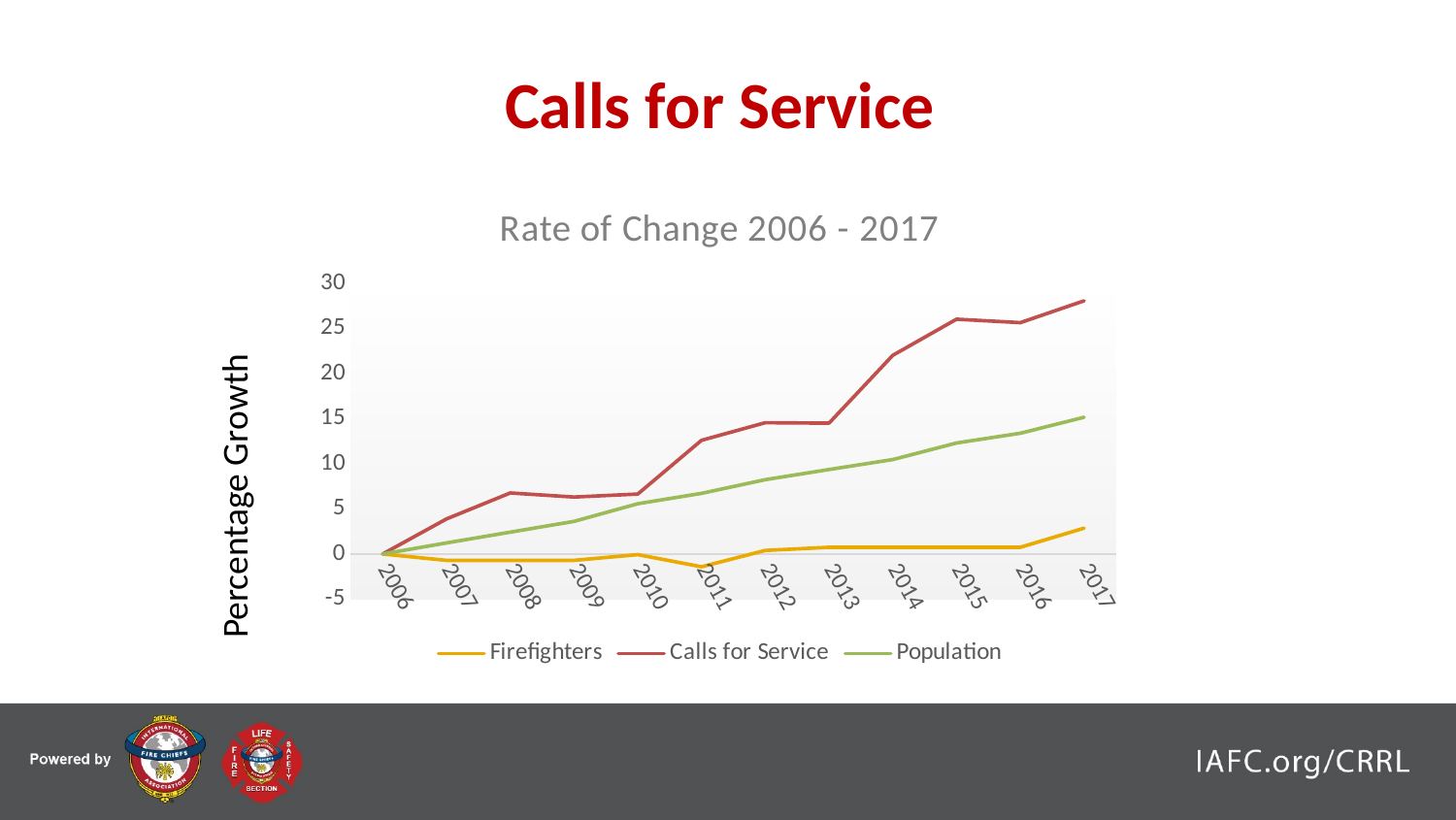
What kind of chart is shown on the slide? Line chart How many series does the legend list? 3 Is the value for Firefighters in 2011 greater or less than 0? less Which is larger in 2017, Calls for Service or Population? Calls for Service What is the label on the vertical axis? Percentage Growth Does the Population line rise or fall from 2006 to 2017? Rises Which series has the highest value in 2017? Calls for Service Is the value for Calls for Service in 2017 greater or less than 25? greater Is the value for Firefighters in 2017 greater or less than 5? less Which series has the lowest value in 2017? Firefighters What is the title of the chart? Rate of Change 2006 - 2017 How many years are plotted along the x axis? 12